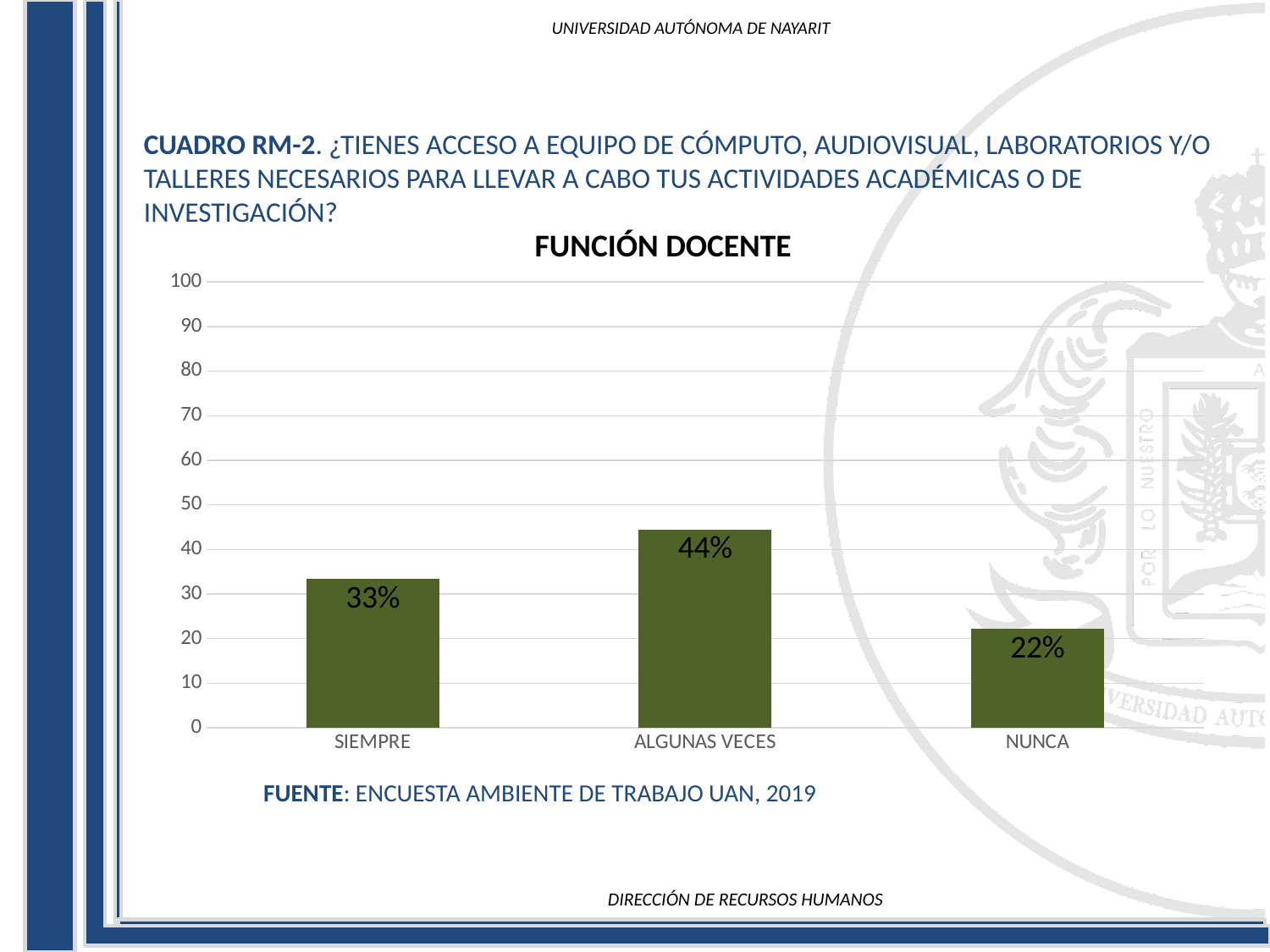
Which category has the highest value? ALGUNAS VECES Is the value for ALGUNAS VECES greater or less than 40? greater What is the value for NUNCA? 22% What is the difference between the values for ALGUNAS VECES and SIEMPRE? 11% What is the difference between the values for SIEMPRE and NUNCA? 11% What is the value for ALGUNAS VECES? 44% What is the title of the chart? FUNCIÓN DOCENTE What is the value for SIEMPRE? 33% How many categories are shown on the x axis? 3 Which is larger, the value for SIEMPRE or the value for NUNCA? SIEMPRE Which category has the lowest value? NUNCA What kind of chart is shown on the slide? bar chart